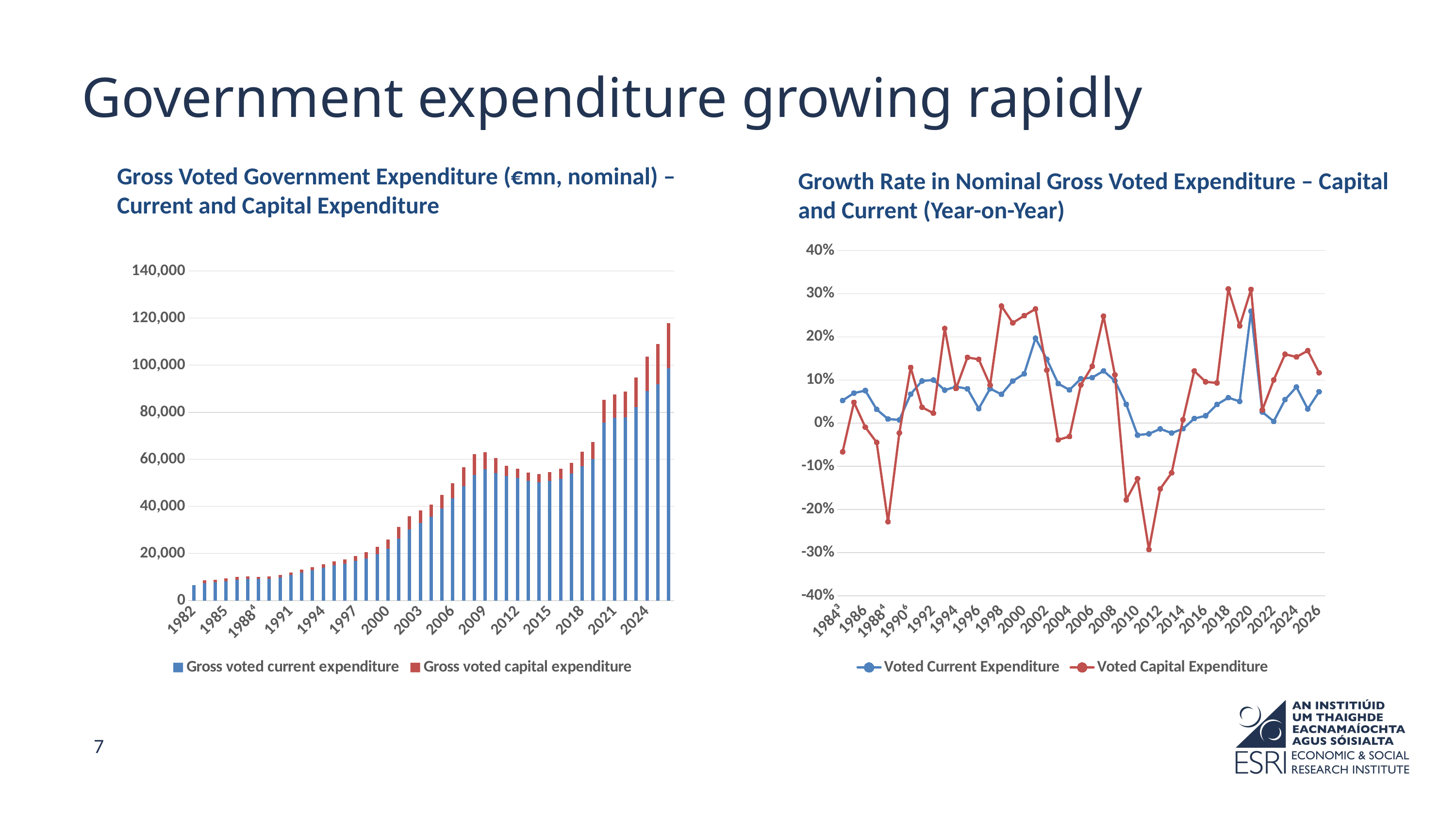
How many series does the legend of the right chart list? 2 How many series does the legend of the left chart list? 2 In the right chart, is the growth rate for Voted Capital Expenditure in 2010 greater or less than -10%? less In the left chart, which colour represents gross voted capital expenditure? Red In the left chart, do total gross voted expenditure values generally rise or fall from 1982 to the end of the series? Rise What kind of chart is the left chart, 'Gross Voted Government Expenditure (€mn, nominal) – Current and Capital Expenditure'? Stacked bar chart In the right chart, which year has the highest growth rate for Voted Current Expenditure? 2020 What kind of chart is the right chart, 'Growth Rate in Nominal Gross Voted Expenditure – Capital and Current (Year-on-Year)'? Line chart In the left chart, is the total gross voted expenditure for 2024 greater or less than 80,000? greater In the right chart, in 2010, which series has the higher growth rate: Voted Current Expenditure or Voted Capital Expenditure? Voted Current Expenditure In the left chart, is the total gross voted expenditure for 1982 greater or less than 20,000? less